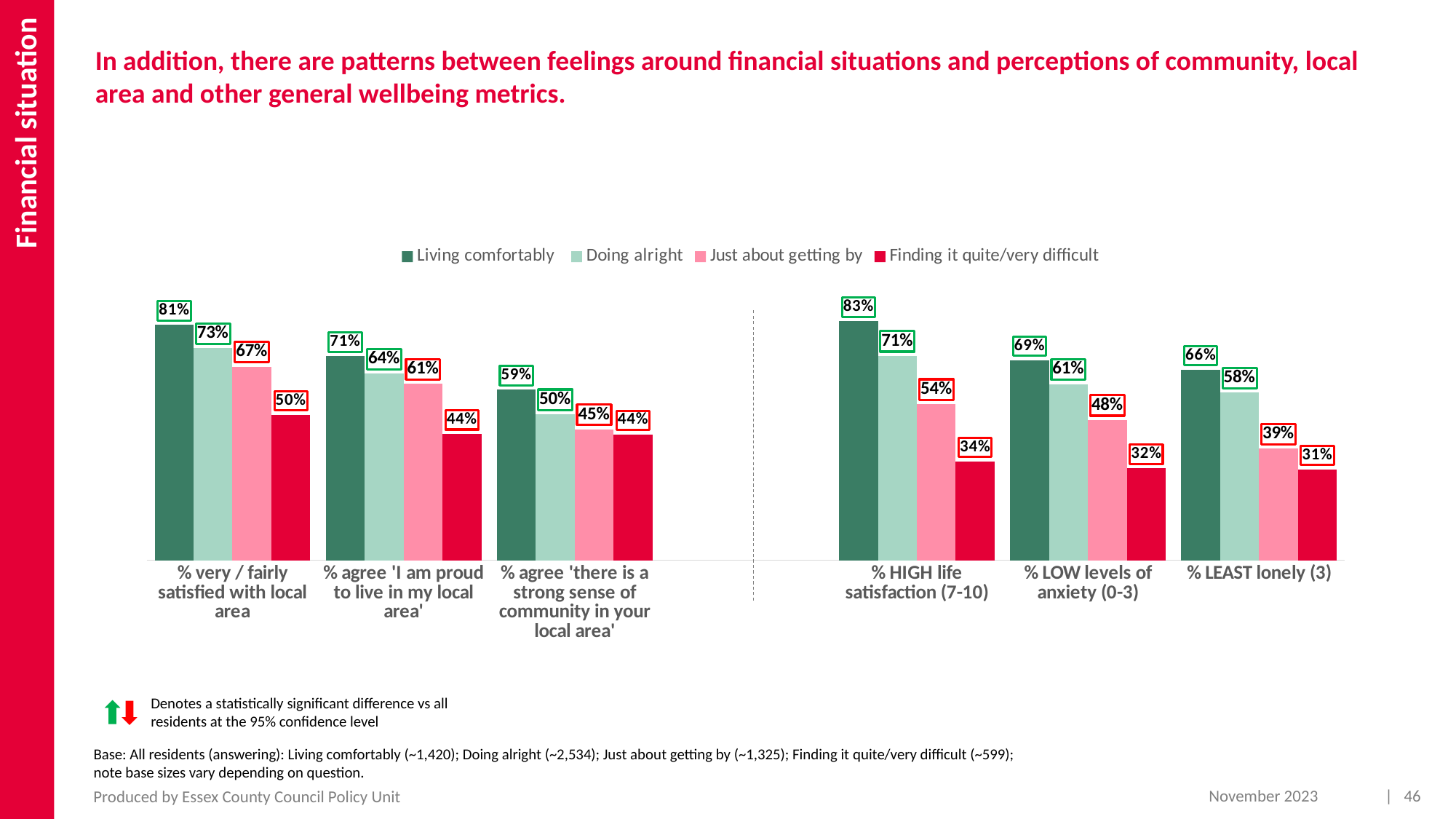
Which is larger: 'Doing alright' in '% agree 'I am proud to live in my local area'' or 'Doing alright' in '% LEAST lonely (3)'? % agree 'I am proud to live in my local area' Which series has the highest value in the '% LOW levels of anxiety (0-3)' category? Living comfortably How many series does the legend list? 4 What is the difference between 'Living comfortably' and 'Finding it quite/very difficult' in the '% HIGH life satisfaction (7-10)' category? 49 percentage points What kind of chart is shown on the slide? bar chart What colour are the bars for the 'Finding it quite/very difficult' series? red What is the value for 'Finding it quite/very difficult' in the '% very / fairly satisfied with local area' category? 50% How many categories are shown along the x axis? 6 What is the value for 'Living comfortably' in the '% HIGH life satisfaction (7-10)' category? 83% What is the value for 'Just about getting by' in the '% LEAST lonely (3)' category? 39% Which category has the lowest value for 'Finding it quite/very difficult'? % LEAST lonely (3) Within each category, do the values rise or fall from 'Living comfortably' to 'Finding it quite/very difficult'? fall